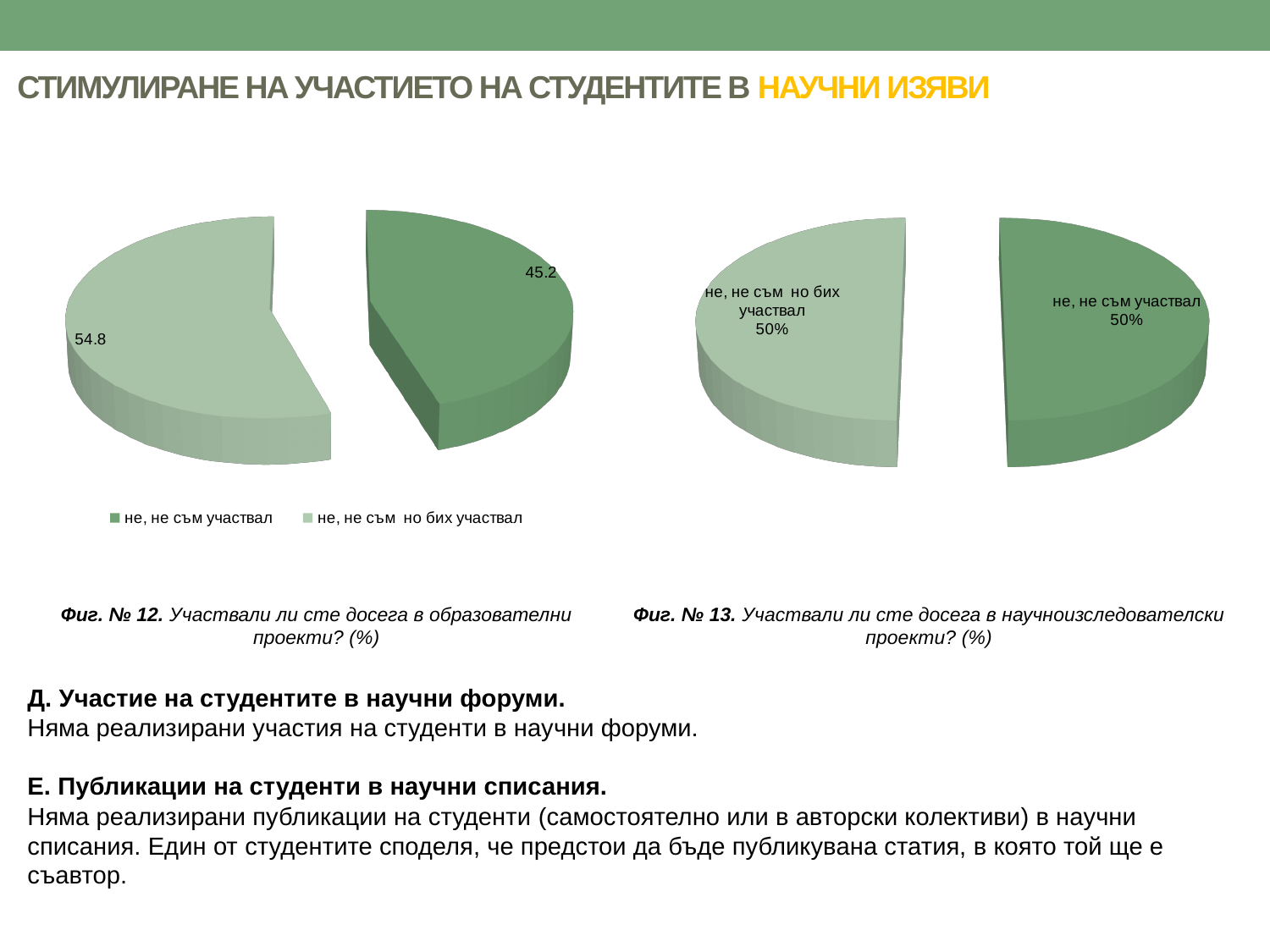
What kind of chart is the left chart (Фиг. № 12)? Pie chart In the left chart (Фиг. № 12), which slice is the smallest? не, не съм участвал How many entries does the legend of the left chart (Фиг. № 12) list? 2 In the left chart (Фиг. № 12), which slice is drawn in the darker green? не, не съм участвал In the right chart (Фиг. № 13), what share is shown for 'не, не съм участвал'? 50% In the left chart (Фиг. № 12), what is the difference between the two slice values? 9.6 In the left chart (Фиг. № 12), which slice is the largest? не, не съм но бих участвал How many slices does the right chart (Фиг. № 13) have? 2 In the left chart (Фиг. № 12), what value is shown for the slice 'не, не съм участвал'? 45.2 In the left chart (Фиг. № 12), which is larger: 'не, не съм участвал' or 'не, не съм но бих участвал'? не, не съм но бих участвал In the left chart (Фиг. № 12), what value is shown for the slice 'не, не съм но бих участвал'? 54.8 In the right chart (Фиг. № 13), what share is shown for 'не, не съм но бих участвал'? 50%